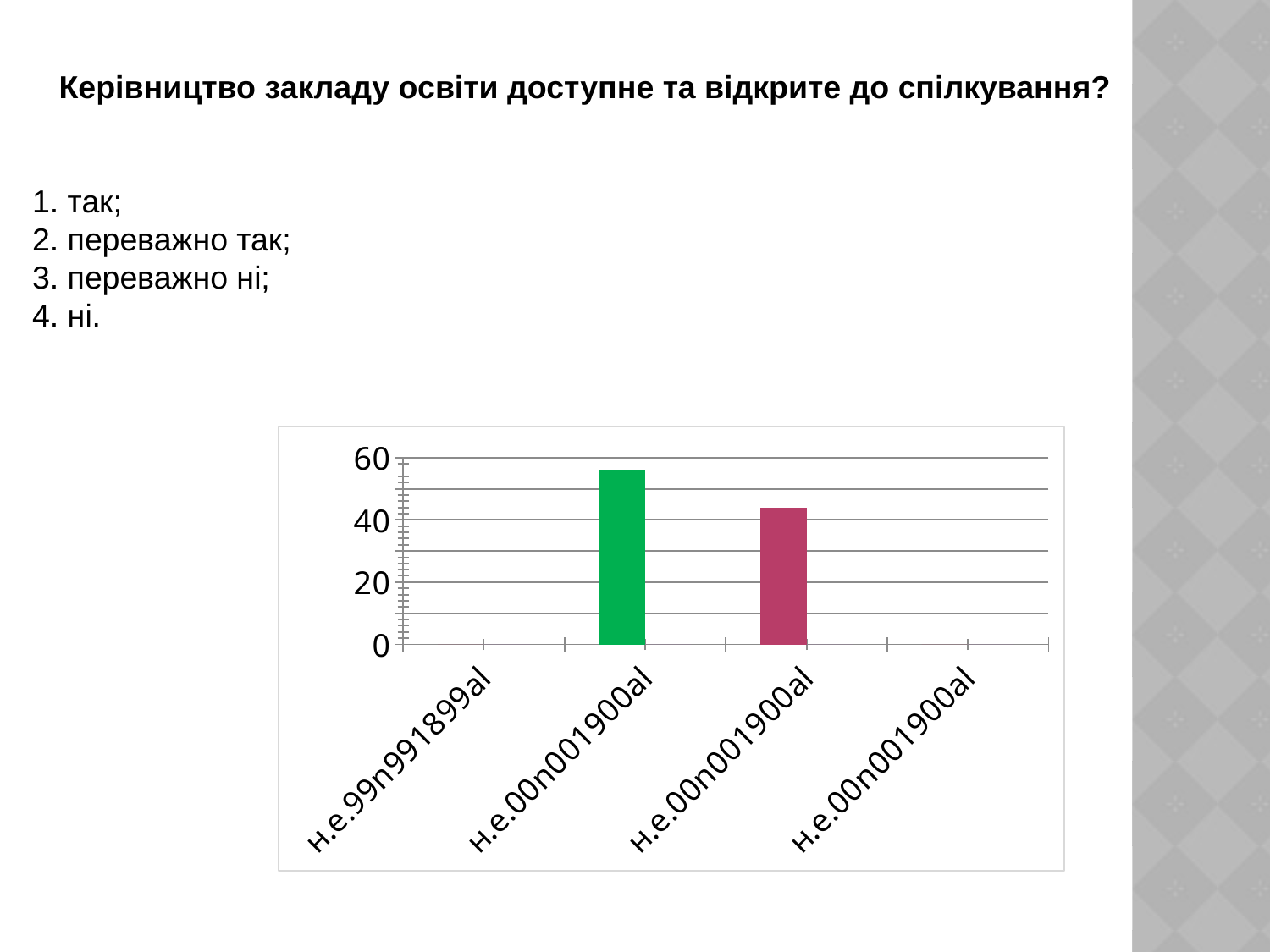
Is the value of the pink bar greater or less than 20? greater Which bar is the tallest in the chart, the green one or the pink one? the green one Is the value of the green bar greater or less than 40? greater What kind of chart is shown on the slide? bar chart How many categories are shown along the x axis of the chart? 4 What colour is the bar in the second category from the left? green Is the value of the green bar greater or less than 60? less Is the green bar taller or shorter than the pink bar? taller What is the highest value labelled on the vertical axis of the chart? 60 How many bars with a visible non-zero value are plotted in the chart? 2